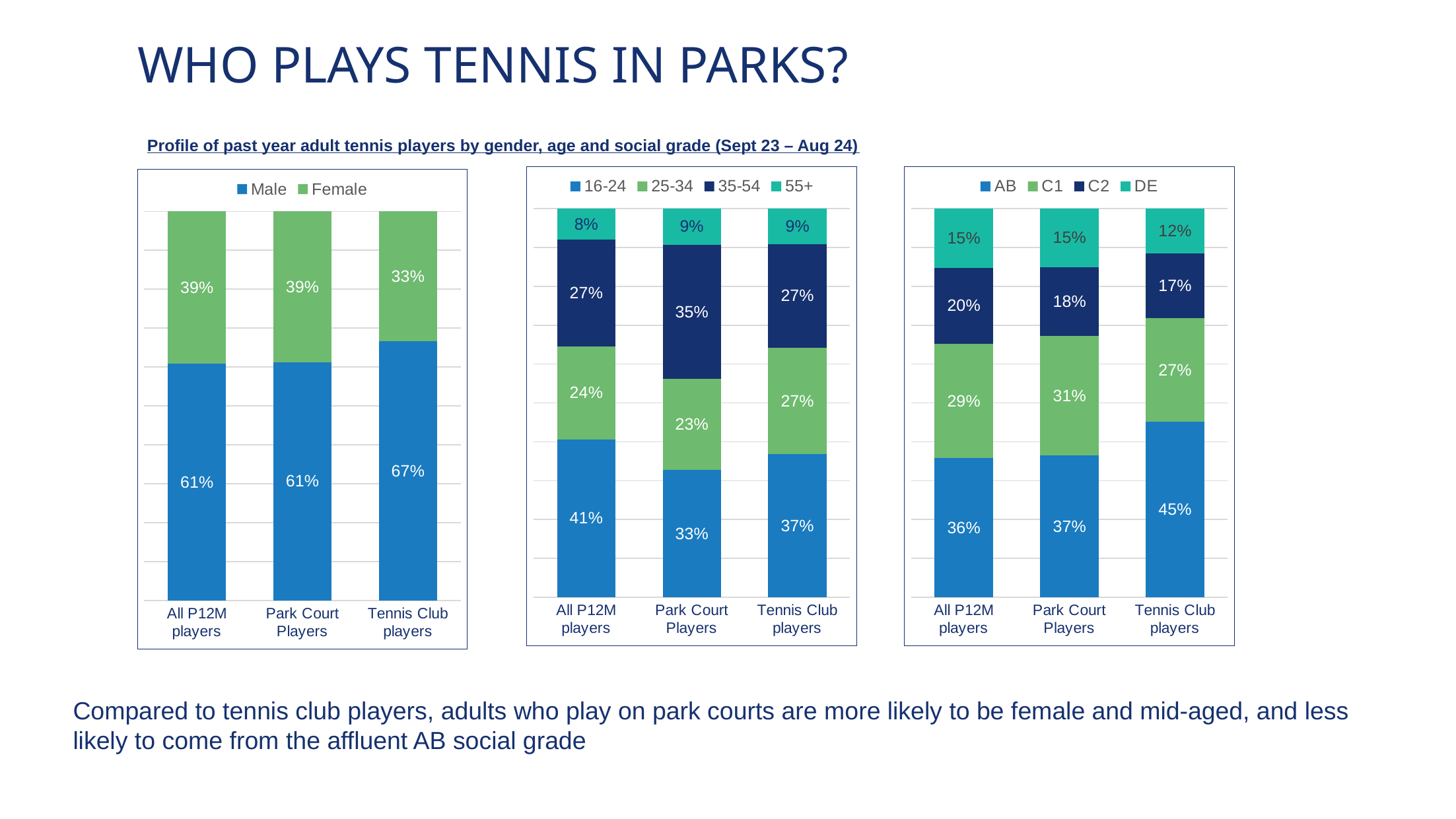
In the left-hand gender chart, what percentage of Tennis Club players are male? 67% In the right-hand social grade chart, what percentage of Tennis Club players are in the AB social grade? 45% In the middle age chart, what percentage of All P12M players are aged 16-24? 41% In the right-hand social grade chart, which category has the lowest DE share? Tennis Club players In the right-hand social grade chart, what is the difference between the AB share for Tennis Club players and for Park Court Players? 8% In the middle age chart, what percentage of Park Court Players are aged 35-54? 35% In the middle age chart, is the 35-54 share larger for Park Court Players or for Tennis Club players? Park Court Players What type of chart is the right-hand social grade chart? Stacked bar chart How many categories are shown on the x axis of the left-hand gender chart? 3 How many series does the legend of the middle age chart list? 4 In the left-hand gender chart, what percentage of Park Court Players are female? 39% In the middle age chart, which category has the highest 16-24 share? All P12M players